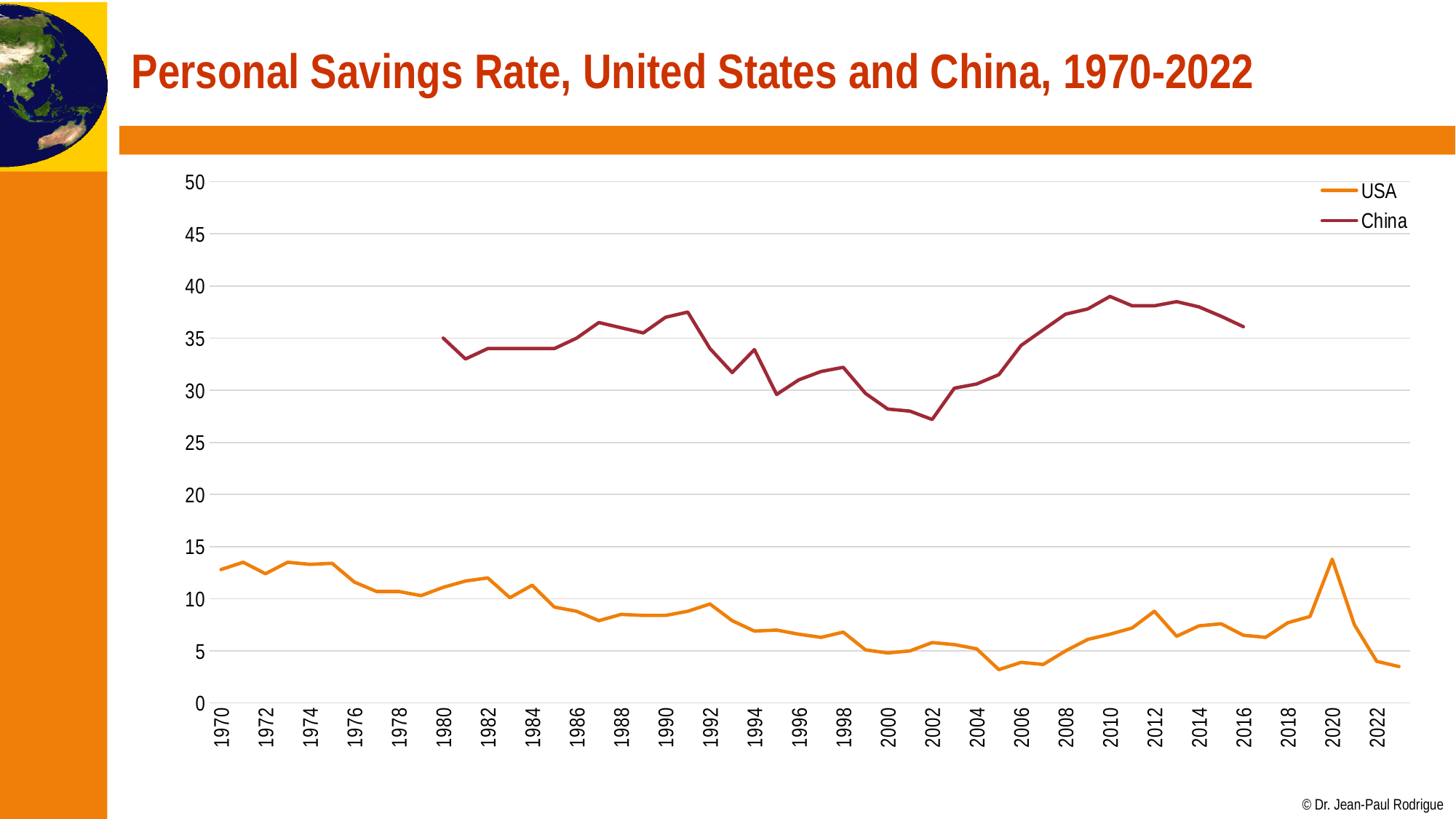
What is the title of the slide's chart? Personal Savings Rate, United States and China, 1970-2022 Is the value for China in 2010 greater or less than 35? greater What are the two series named in the legend? USA and China What kind of chart is shown on the slide? line chart Does the China line rise or fall from 2002 to 2010? rise Is the value for China in 2002 greater or less than 30? less Does the USA line generally rise or fall from 1970 to 2005? fall In 2000, which series has the higher value, USA or China? China Is the value for USA in 2005 greater or less than 5? less How many series does the legend list? 2